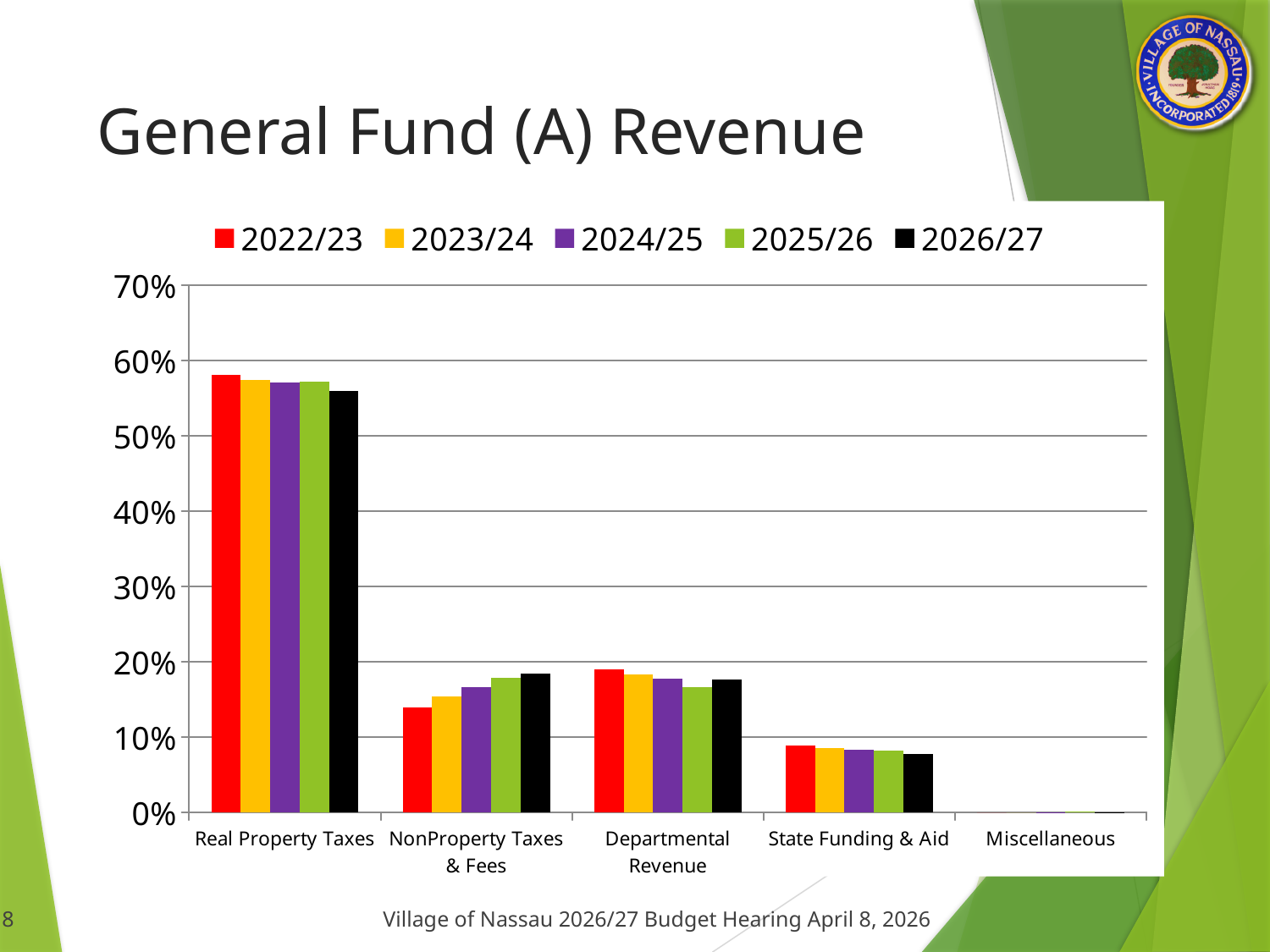
Does the share for NonProperty Taxes & Fees rise or fall from 2022/23 to 2026/27? rise Is the value for State Funding & Aid in 2026/27 greater or less than 10%? less How many series does the legend list? 5 Is the value for Real Property Taxes in 2022/23 greater or less than 50%? greater Is the value for NonProperty Taxes & Fees in 2022/23 greater or less than 20%? less For 2026/27, which is larger: NonProperty Taxes & Fees or State Funding & Aid? NonProperty Taxes & Fees What colour represents the 2026/27 series in the legend? black Which revenue category has the lowest share for 2022/23? Miscellaneous How many revenue categories are shown on the x axis? 5 Which revenue category has the highest share for 2026/27? Real Property Taxes What kind of chart is shown on the slide? bar chart